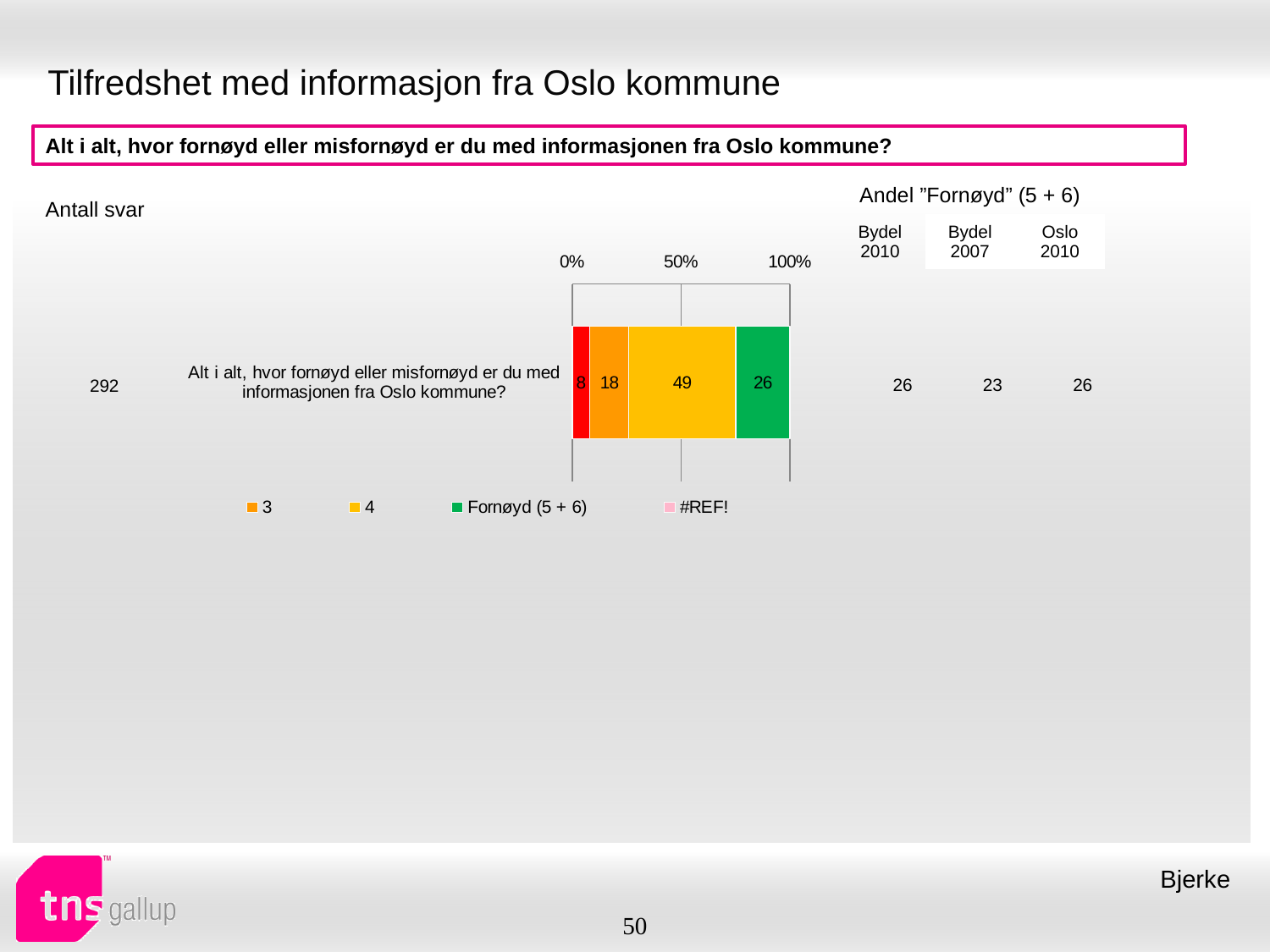
What kind of chart is shown on the slide? stacked bar chart How many entries does the chart legend list? 4 What is the smallest value printed on the bar? 8 What colour is the Fornøyd (5 + 6) segment in the chart? green Which is larger, the segment for category 4 or the Fornøyd (5 + 6) segment? 4 What is the value of the segment for category 4 in the bar? 49 How many bars does the chart contain? 1 What is the value of the segment for category 3 in the bar? 18 What is the difference between the segment for category 4 and the Fornøyd (5 + 6) segment? 23 What is the value of the Fornøyd (5 + 6) segment in the bar? 26 What is the total of all the values printed on the stacked bar? 101 Which segment of the bar has the largest value? 4 (49)